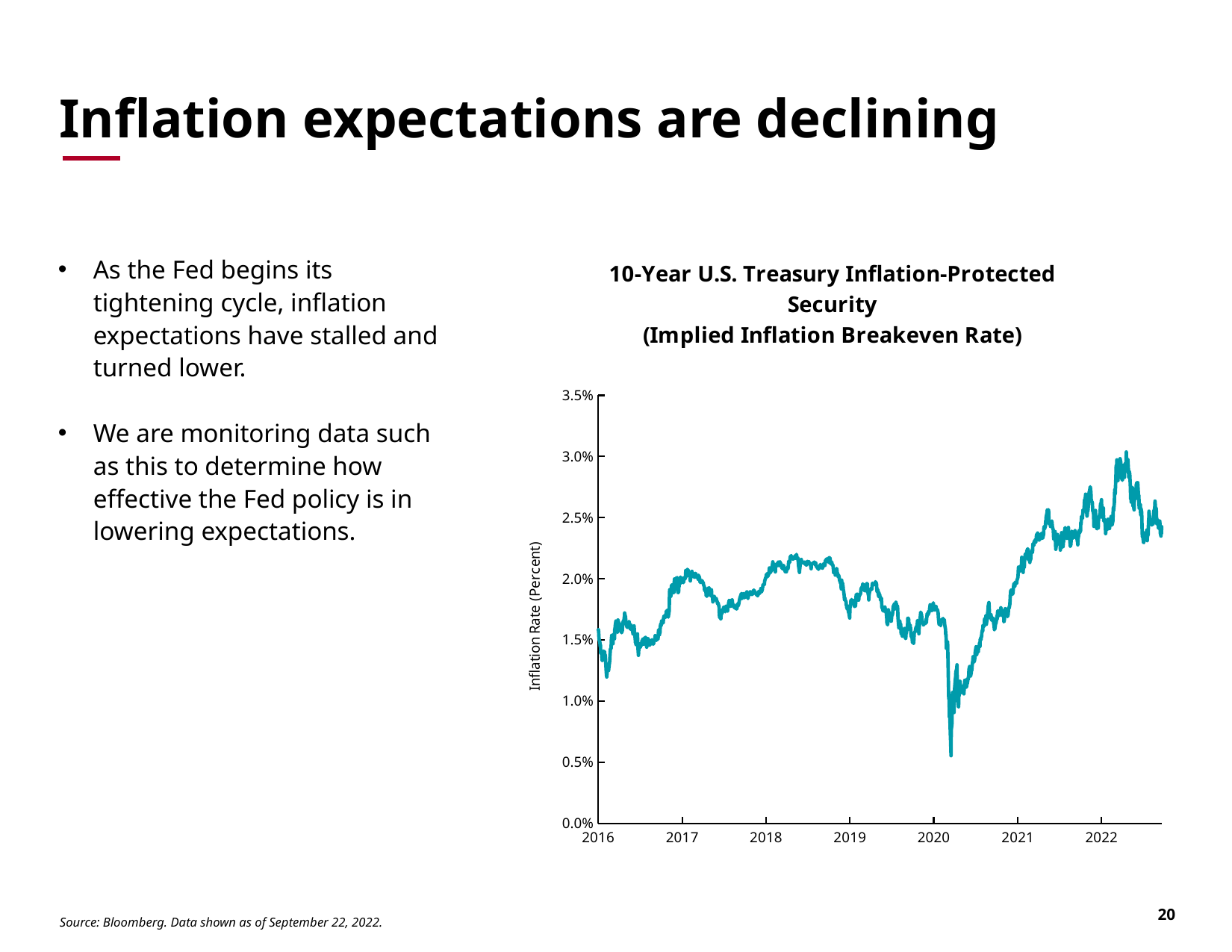
Does the line generally rise or fall from mid-2018 to early 2020? fall In which year does the line reach its lowest point? 2020 Is the value of the line in late 2019 greater or less than 2.0%? less Is the peak value of the line in 2022 greater or less than 2.5%? greater What kind of chart is shown on the slide? line chart Is the lowest value of the line in 2020 greater or less than 1.0%? less Does the line generally rise or fall between its 2020 low and its 2022 peak? rise In which year does the line reach its highest point? 2022 How many year labels are shown on the horizontal axis? 7 What is the label on the vertical axis of the chart? Inflation Rate (Percent) What is the title of the chart? 10-Year U.S. Treasury Inflation-Protected Security (Implied Inflation Breakeven Rate)